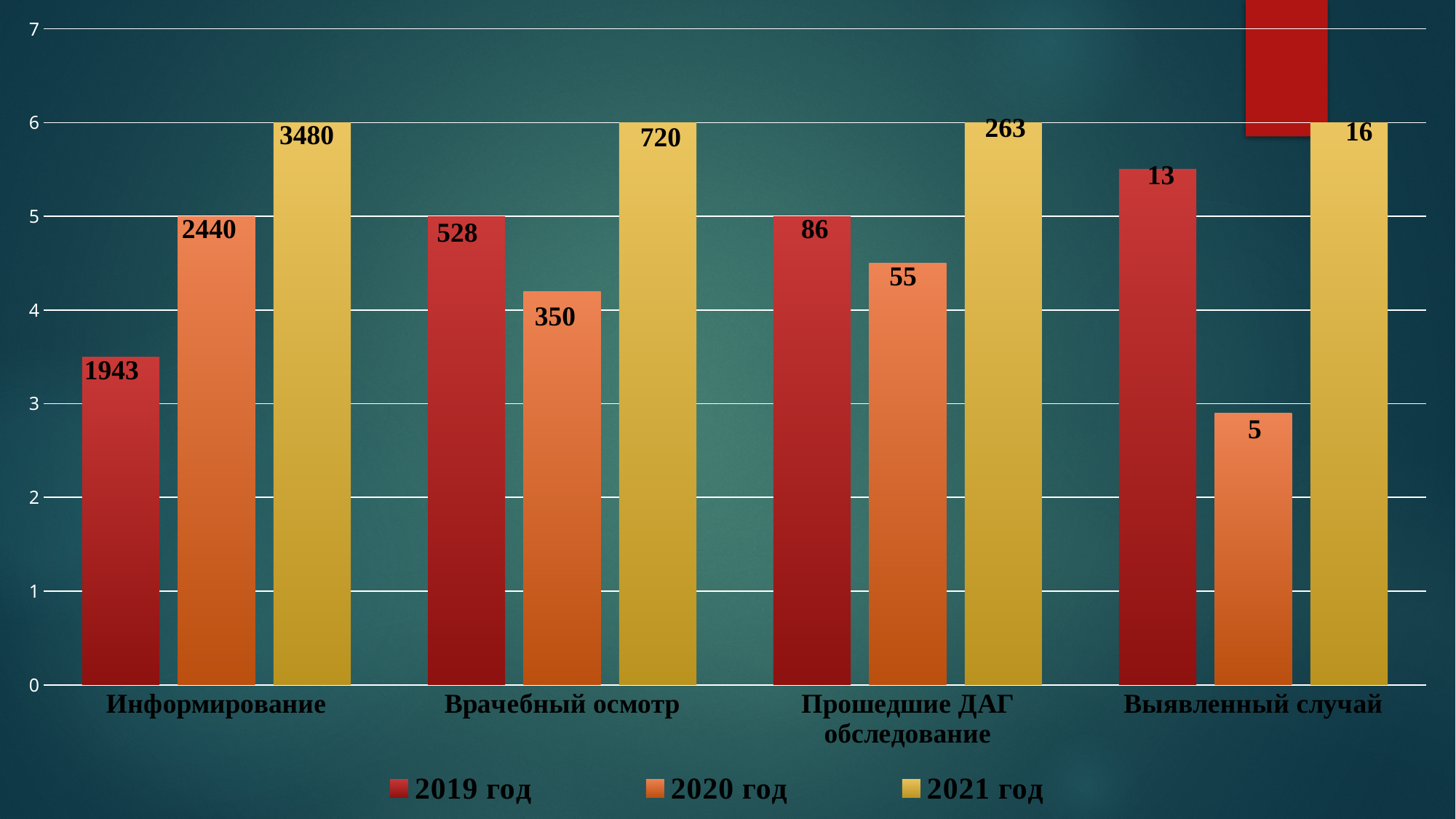
How many categories are shown on the x axis? 4 What is the value for Врачебный осмотр in the 2020 год series? 350 What is the difference between the 2019 год and 2020 год values for Врачебный осмотр? 178 What kind of chart is shown on the slide? Bar chart How many series does the legend list? 3 What is the value for Информирование in the 2021 год series? 3480 For Прошедшие ДАГ обследование, which is larger: the 2019 год value or the 2021 год value? 2021 год Which category has the lowest value in the 2020 год series? Выявленный случай Which category has the highest value in the 2021 год series? Информирование What is the value for Прошедшие ДАГ обследование in the 2020 год series? 55 What is the difference between the 2021 год and 2019 год values for Информирование? 1537 What is the value for Выявленный случай in the 2019 год series? 13